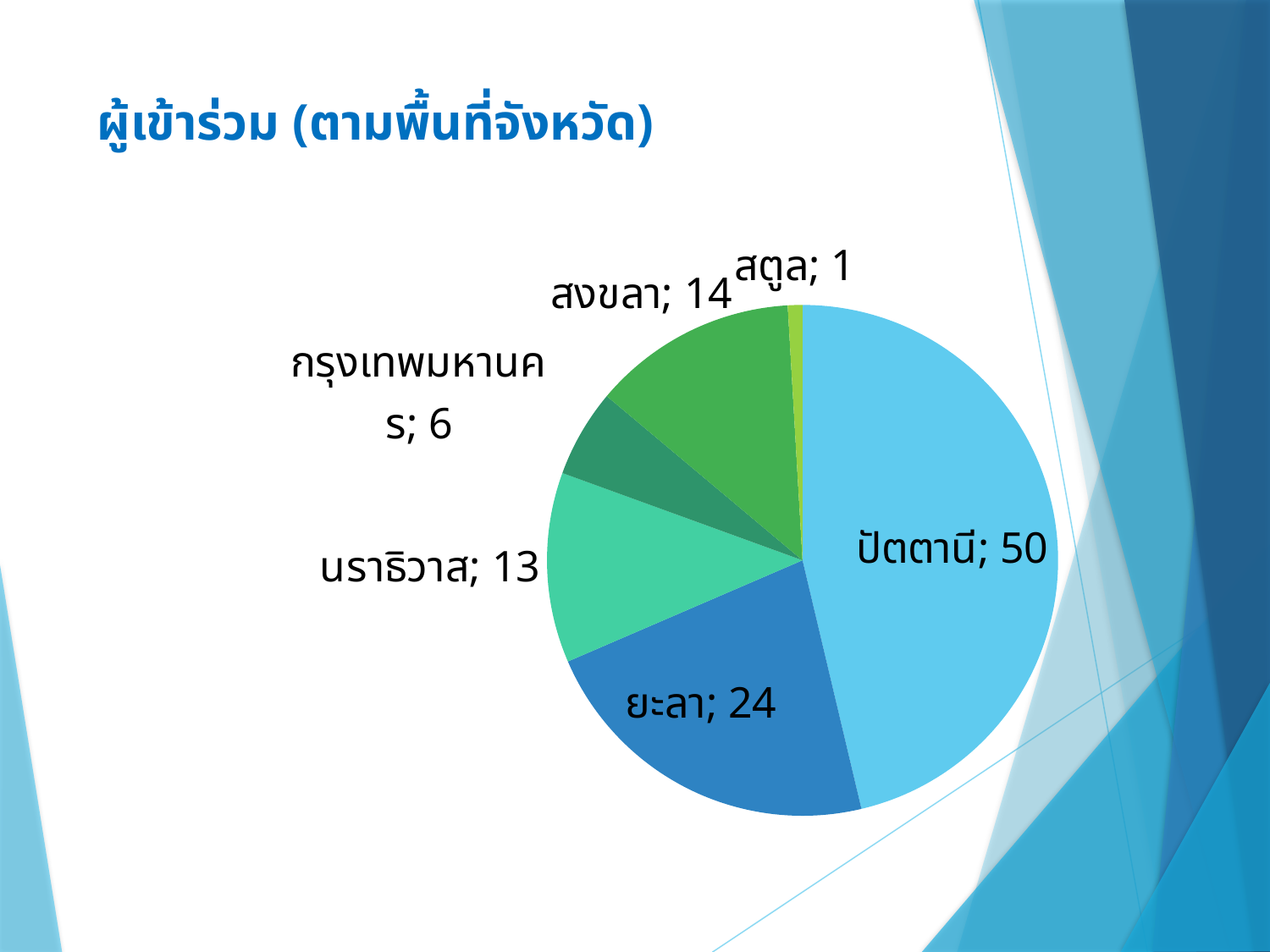
Which province has the smallest slice? สตูล What is the value for กรุงเทพมหานคร? 6 Which province has the largest slice? ปัตตานี Which is larger, the value for นราธิวาส or the value for สงขลา? สงขลา How many slices does the pie chart have? 6 What is the value for สงขลา? 14 What kind of chart is shown on the slide? pie chart What is the difference between the values for ปัตตานี and ยะลา? 26 What is the value for ปัตตานี? 50 What is the total of all slices in the pie chart? 108 What is the value for ยะลา? 24 What is the title of the chart? ผู้เข้าร่วม (ตามพื้นที่จังหวัด)